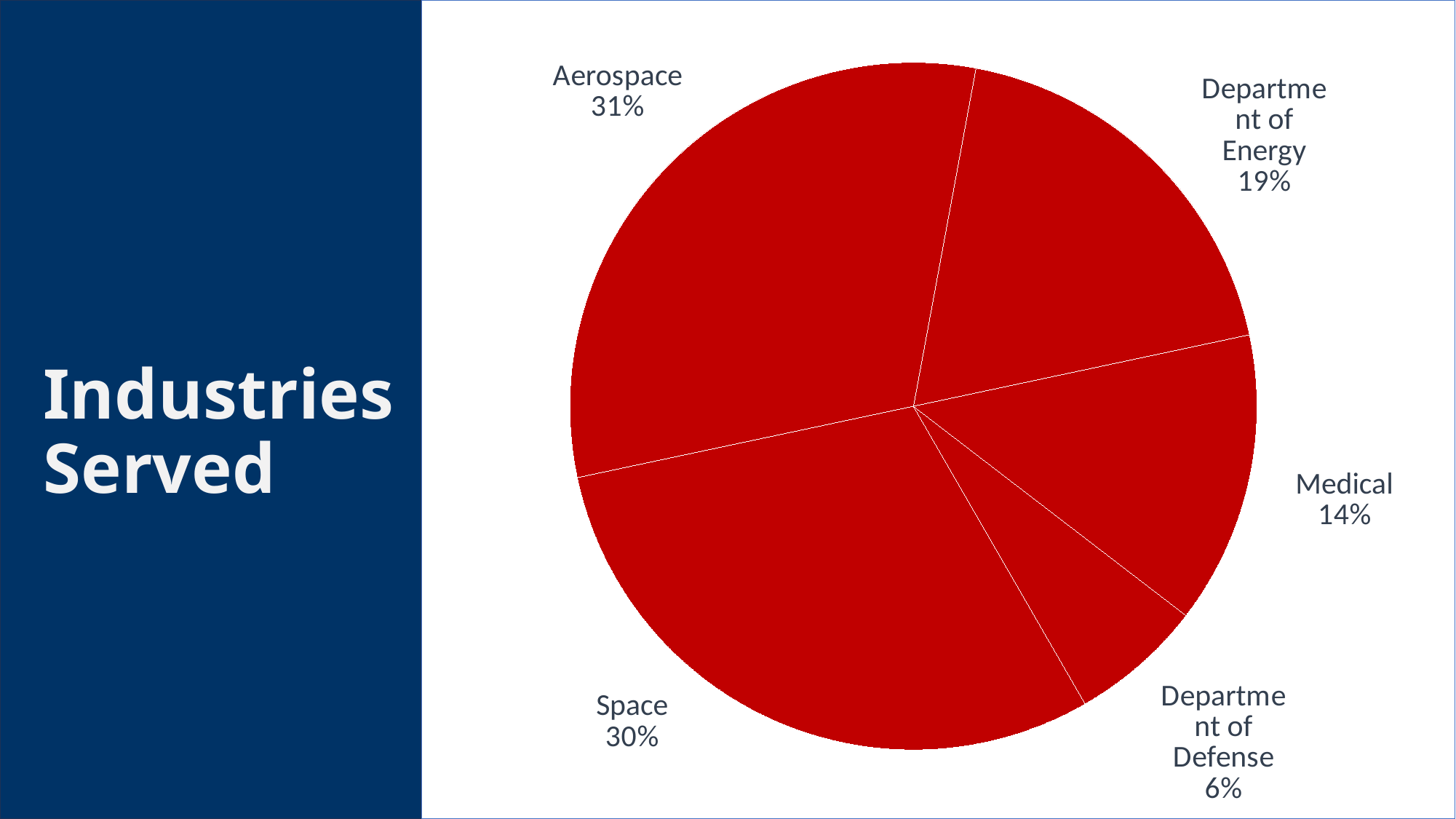
What share of the pie does Department of Energy represent? 19% What share of the pie does Department of Defense represent? 6% Which industry has the largest share of the pie? Aerospace What kind of chart is shown on the slide? Pie chart What share of the pie does Medical represent? 14% Which industry has the smallest share of the pie? Department of Defense Which is larger, the Medical share or the Department of Defense share? Medical What is the title shown on the slide next to the chart? Industries Served How many slices does the pie chart have? 5 What is the difference in percentage points between the Department of Energy and Medical shares? 5